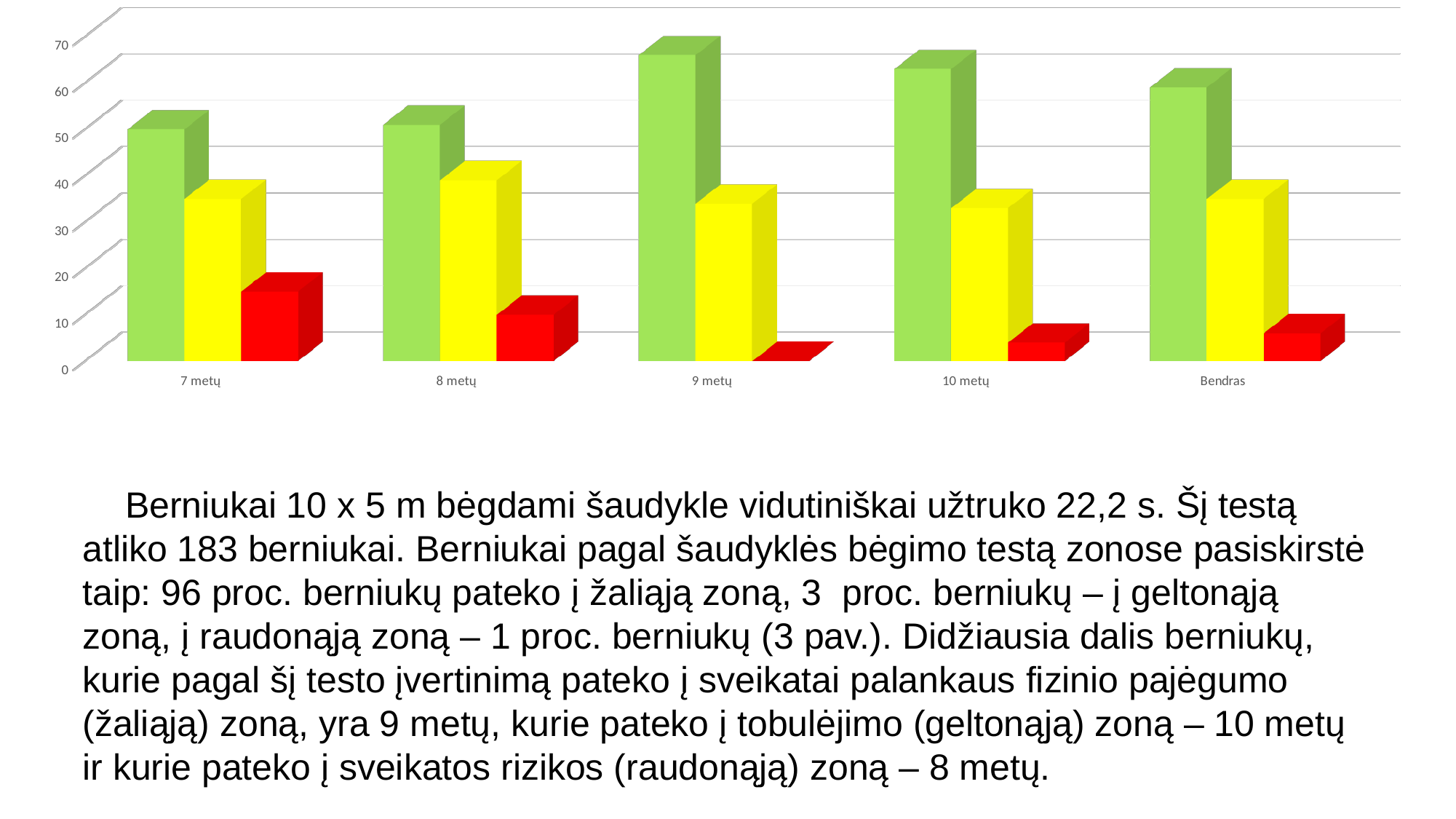
Is the yellow bar for 8 metų greater or less than 30? greater Which category has the tallest red bar? 7 metų How many bars are plotted for each category in the chart? 3 What colours are the three bars in each category of the chart? green, yellow and red Which category has the shortest red bar? 9 metų Is the green bar for 9 metų greater or less than 60? greater What kind of chart is shown on the slide? bar chart Which category has the tallest green bar? 9 metų Is the red bar for 8 metų greater or less than 20? less Which is taller, the green bar for 10 metų or the green bar for 8 metų? 10 metų How many categories are shown on the x axis of the chart? 5